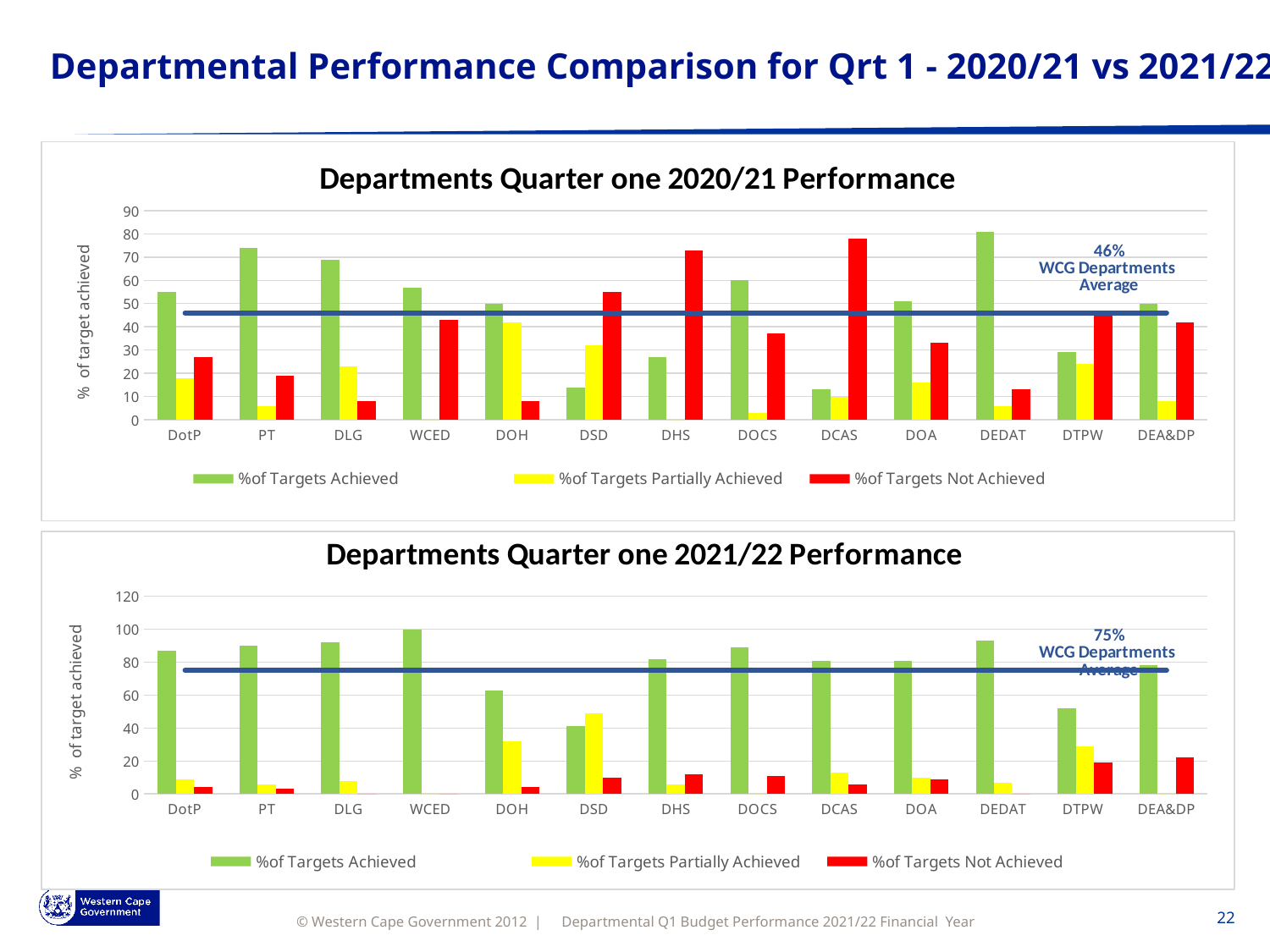
In the 'Departments Quarter one 2020/21 Performance' chart, is the % of Targets Not Achieved for DHS greater or less than 60? greater In the 'Departments Quarter one 2021/22 Performance' chart, which department has the lowest % of Targets Achieved? DSD In the 'Departments Quarter one 2020/21 Performance' chart, how many departments are shown on the x axis? 13 In the 'Departments Quarter one 2020/21 Performance' chart, how many series does the legend list? 3 In the 'Departments Quarter one 2021/22 Performance' chart, is the % of Targets Achieved for WCED greater or less than 80? greater What kind of chart is the 'Departments Quarter one 2020/21 Performance' chart? bar chart In the 'Departments Quarter one 2021/22 Performance' chart, what is the WCG Departments Average shown by the horizontal line? 75% In the 'Departments Quarter one 2020/21 Performance' chart, what is the WCG Departments Average shown by the horizontal line? 46% In the 'Departments Quarter one 2021/22 Performance' chart, is the % of Targets Achieved for DOH greater or less than 80? less In the 'Departments Quarter one 2020/21 Performance' chart, which department has the highest % of Targets Achieved? DEDAT In the 'Departments Quarter one 2021/22 Performance' chart, which has the larger % of Targets Partially Achieved, DSD or DOH? DSD